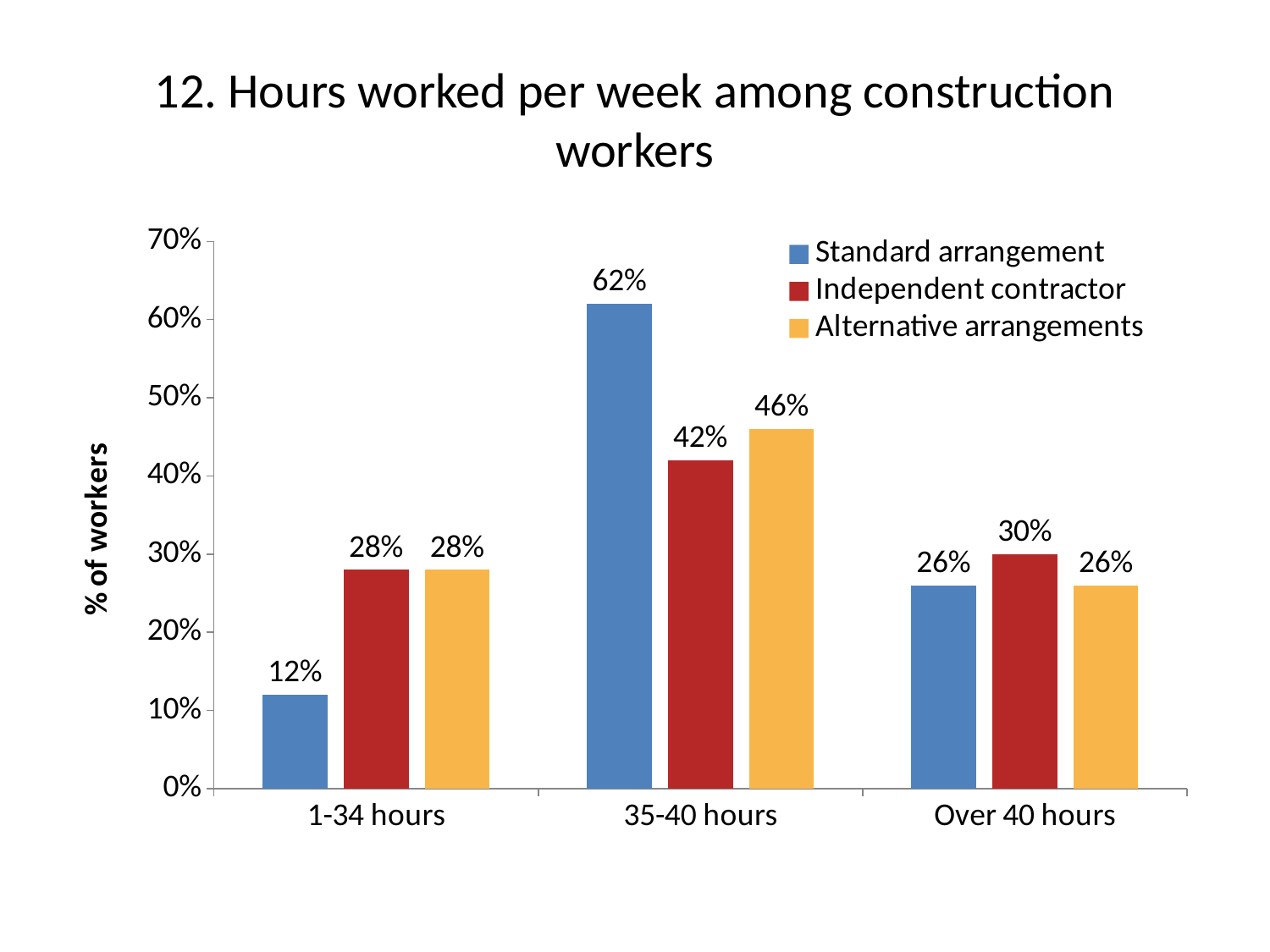
What percentage of workers in alternative arrangements work 1-34 hours? 28% Which hours category has the lowest value for the independent contractor series? 1-34 hours Is the value for alternative arrangements at 35-40 hours greater or less than 40%? greater How many series does the legend list? 3 What percentage of independent contractors work over 40 hours? 30% For 1-34 hours, which is larger: the standard arrangement value or the independent contractor value? Independent contractor What percentage of workers in a standard arrangement work 35-40 hours? 62% How many hours categories are shown on the x axis? 3 What kind of chart is shown on the slide? Bar chart What is the difference between the standard arrangement and independent contractor values for 35-40 hours? 20% What is the label of the vertical axis? % of workers Which hours category has the highest value for the standard arrangement series? 35-40 hours